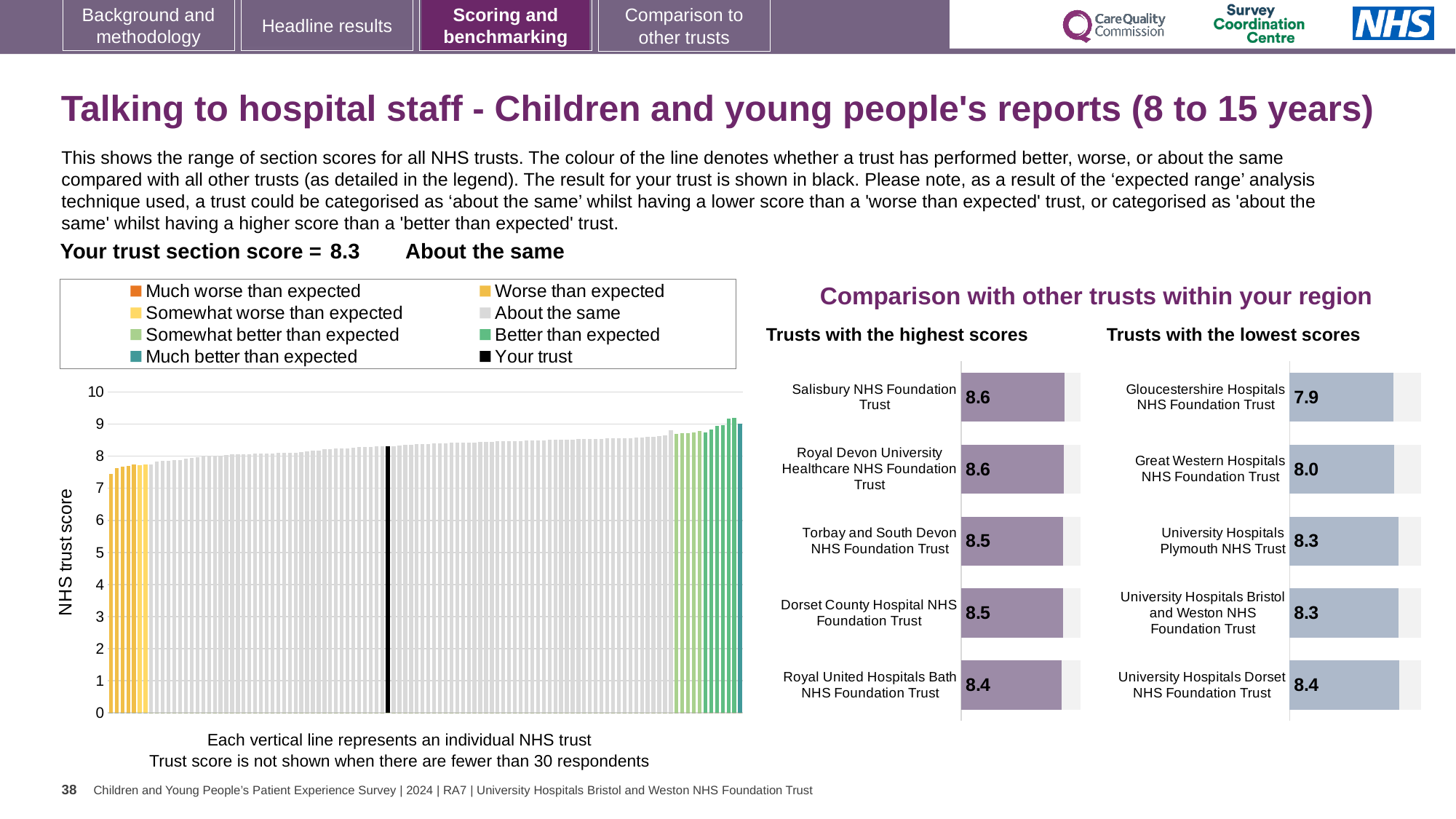
In the 'Trusts with the lowest scores' chart, which has the larger score: Great Western Hospitals NHS Foundation Trust or University Hospitals Plymouth NHS Trust? University Hospitals Plymouth NHS Trust In the 'Trusts with the lowest scores' chart, which trust has the lowest score? Gloucestershire Hospitals NHS Foundation Trust In the main 'NHS trust score' chart, what is the section score for your trust (the black bar)? 8.3 In the 'Trusts with the lowest scores' chart, what is the score for Gloucestershire Hospitals NHS Foundation Trust? 7.9 In the 'Trusts with the highest scores' chart, what is the difference between the scores of Salisbury NHS Foundation Trust and Royal United Hospitals Bath NHS Foundation Trust? 0.2 In the 'Trusts with the lowest scores' chart, what is the difference between the scores of University Hospitals Dorset NHS Foundation Trust and Gloucestershire Hospitals NHS Foundation Trust? 0.5 In the main 'NHS trust score' chart, do the values rise or fall from left to right? Rise What kind of chart is the main chart showing the NHS trust scores for all trusts? Bar chart In the 'Trusts with the lowest scores' chart, which trust has the highest score? University Hospitals Dorset NHS Foundation Trust How many trusts are shown in the 'Trusts with the highest scores' chart? 5 How many entries does the legend of the main 'NHS trust score' chart list? 8 In the 'Trusts with the highest scores' chart, what is the score for Torbay and South Devon NHS Foundation Trust? 8.5